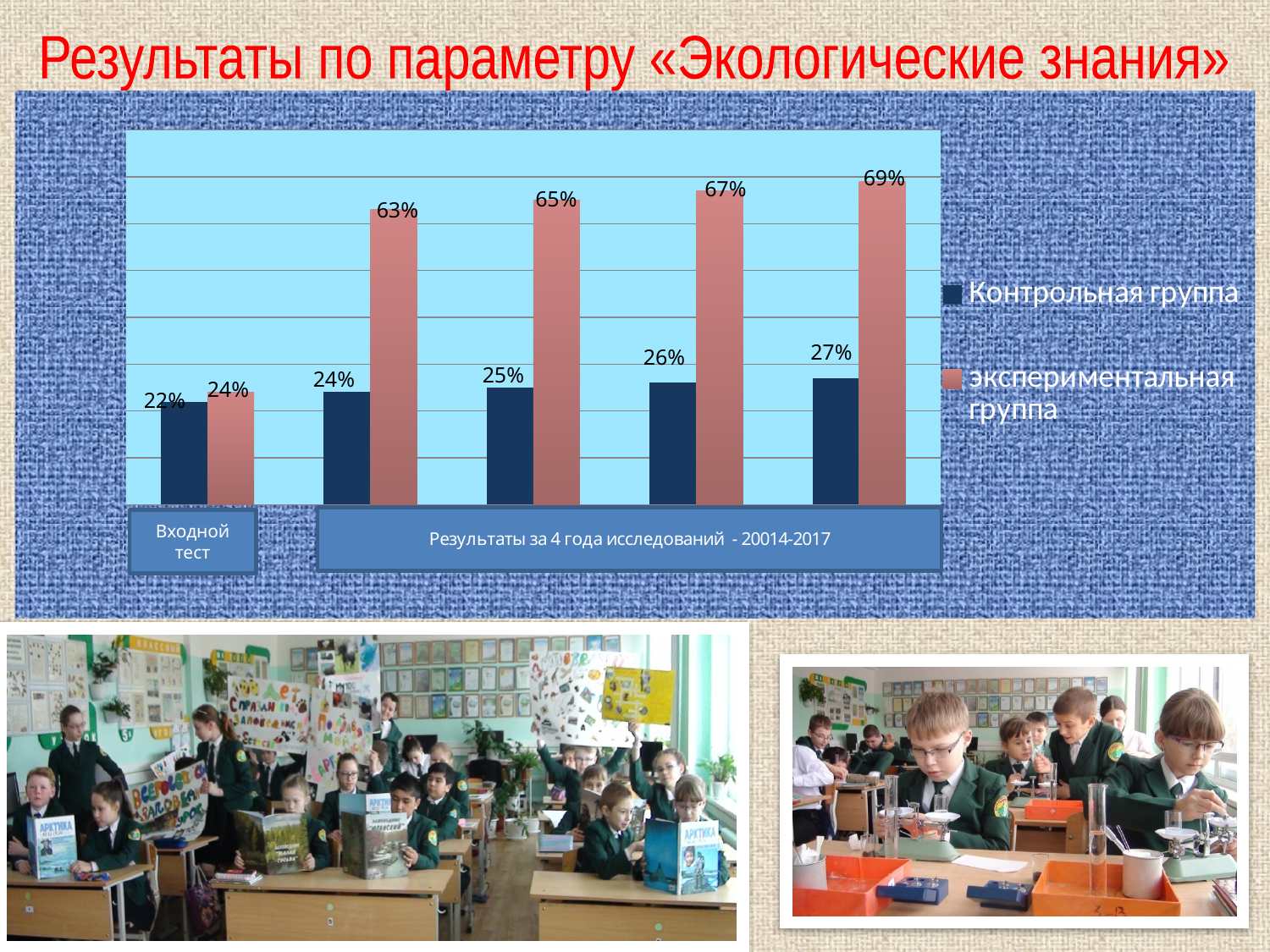
Do the values for the экспериментальная группа series rise or fall from left to right along the x axis? rise In the Входной тест category, which series has the larger value, Контрольная группа or экспериментальная группа? экспериментальная группа What is the value for экспериментальная группа in the Входной тест category? 24% What is the value for Контрольная группа in the Входной тест category? 22% What is the label of the first category on the x axis? Входной тест What is the lowest value shown for the Контрольная группа series? 22% What is the difference between the экспериментальная группа and Контрольная группа values in the Входной тест category? 2% What is the highest value shown for the экспериментальная группа series? 69% What type of chart is shown on the slide? bar chart What is the highest value shown for the Контрольная группа series? 27% How many series does the chart legend list? 2 How many groups of bars are plotted on the chart? 5